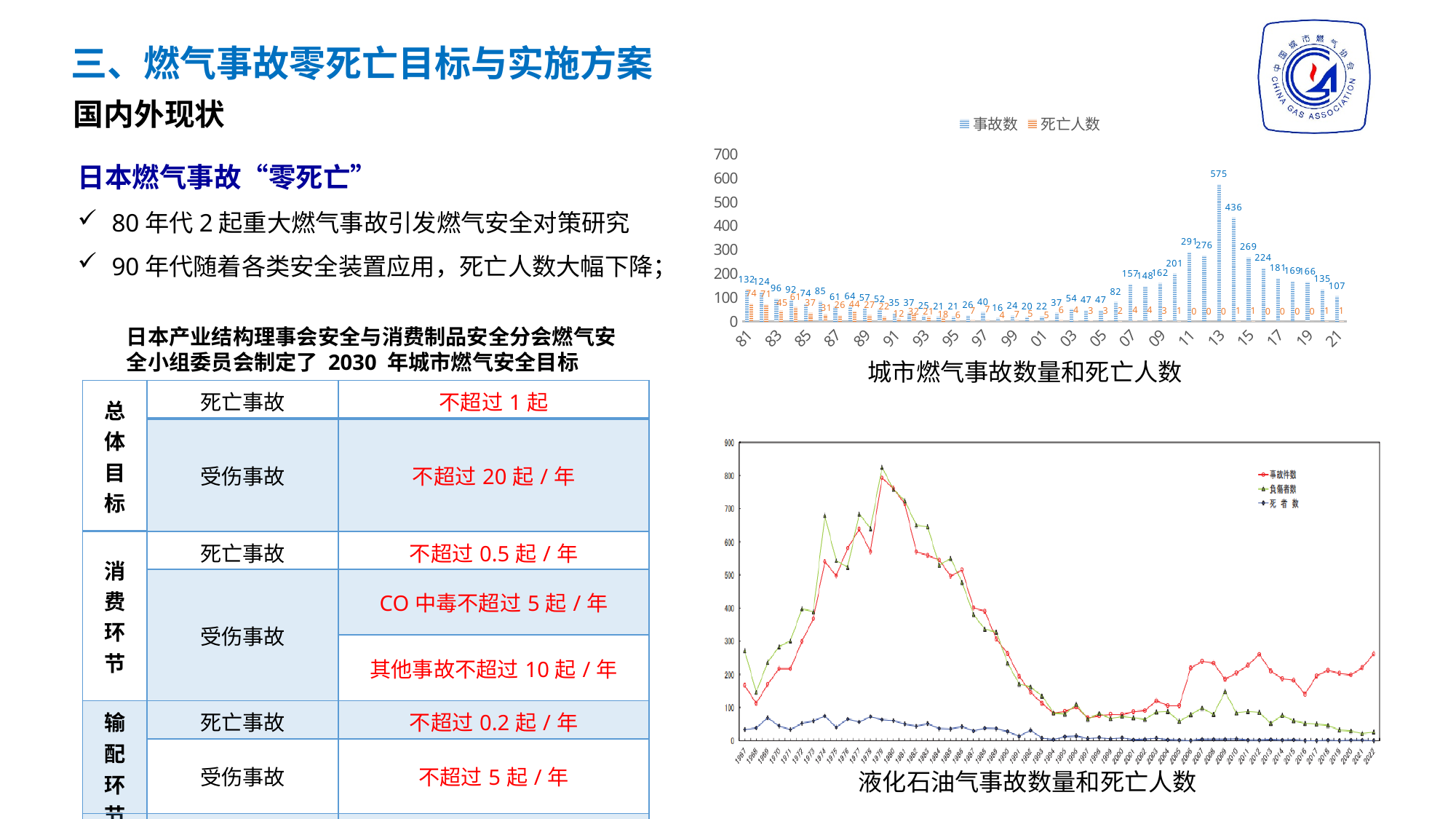
In the chart titled 液化石油气事故数量和死亡人数, does the 事故件数 series rise or fall from 1980 to 1994? fall In the chart titled 城市燃气事故数量和死亡人数, what is the difference between the 事故数 values for year 13 and year 14? 139 In the chart titled 城市燃气事故数量和死亡人数, what is the 事故数 value for year 81? 132 In the chart titled 城市燃气事故数量和死亡人数, which is larger, the 事故数 for year 11 or for year 12? year 11 In the chart titled 城市燃气事故数量和死亡人数, is the 事故数 value for year 13 greater or less than 500? greater In the chart titled 城市燃气事故数量和死亡人数, which year has the highest 事故数? 13 What kind of chart is the chart titled 城市燃气事故数量和死亡人数? bar chart What kind of chart is the chart titled 液化石油气事故数量和死亡人数? line chart In the chart titled 液化石油气事故数量和死亡人数, is the 事故件数 value for 1979 greater or less than 700? greater In the chart titled 城市燃气事故数量和死亡人数, what is the 事故数 value for year 13? 575 How many series does the legend of the chart titled 城市燃气事故数量和死亡人数 list? 2 How many series does the legend of the chart titled 液化石油气事故数量和死亡人数 list? 3